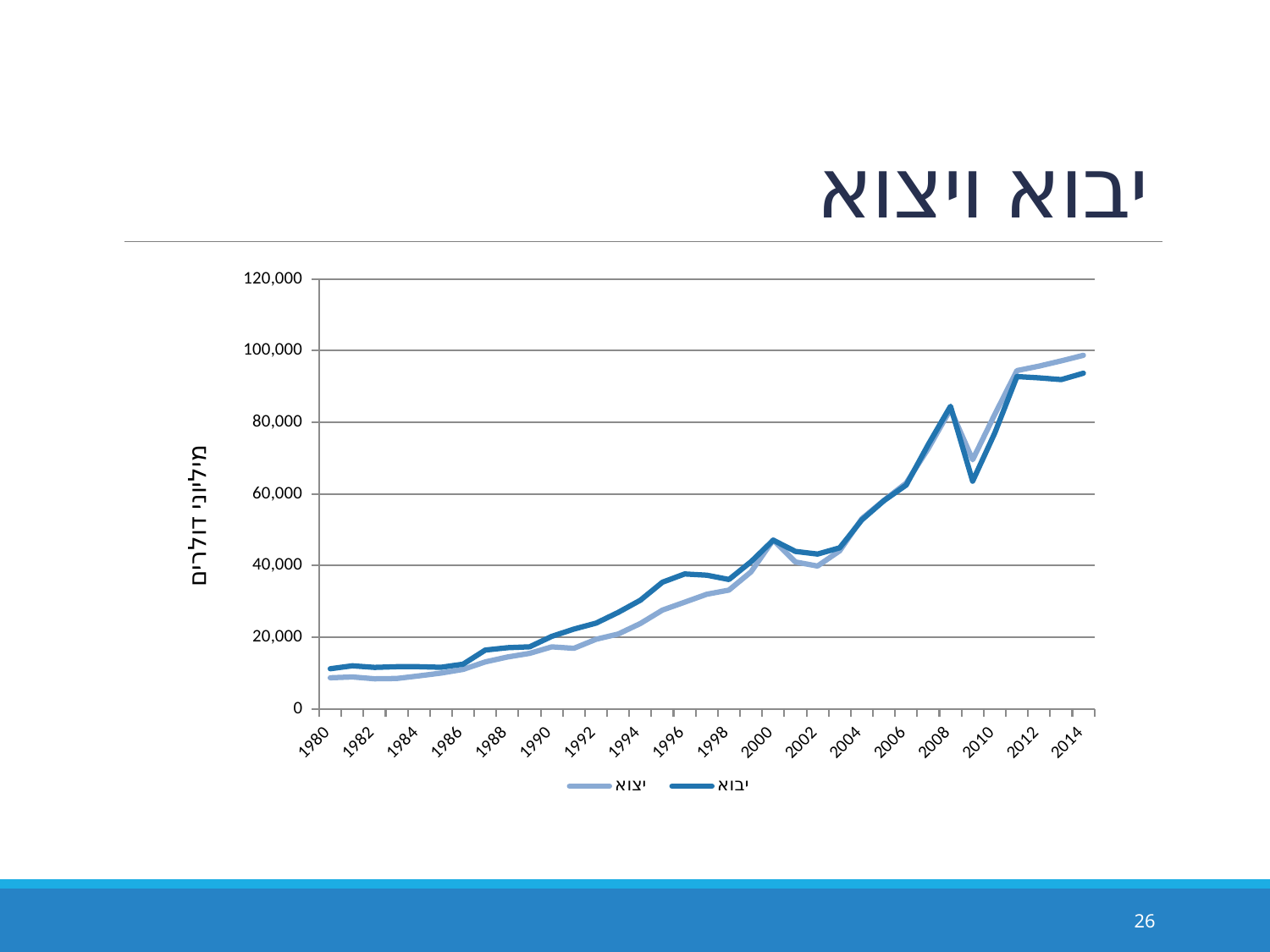
In 1996, which series has the higher value, יבוא or יצוא? יבוא What is the title of the chart on the slide? יבוא ויצוא How many series does the legend list? 2 Is the value for יצוא in 2014 greater or less than 90,000? greater Is the value for יבוא in 2008 greater or less than 80,000? greater Do the values for יבוא generally rise or fall from 1980 to 2014? rise Is the value for יבוא in 2009 greater or less than 80,000? less How many year labels are shown on the horizontal axis? 18 What is the label on the vertical axis of the chart? מיליוני דולרים What kind of chart is shown on the slide? line chart